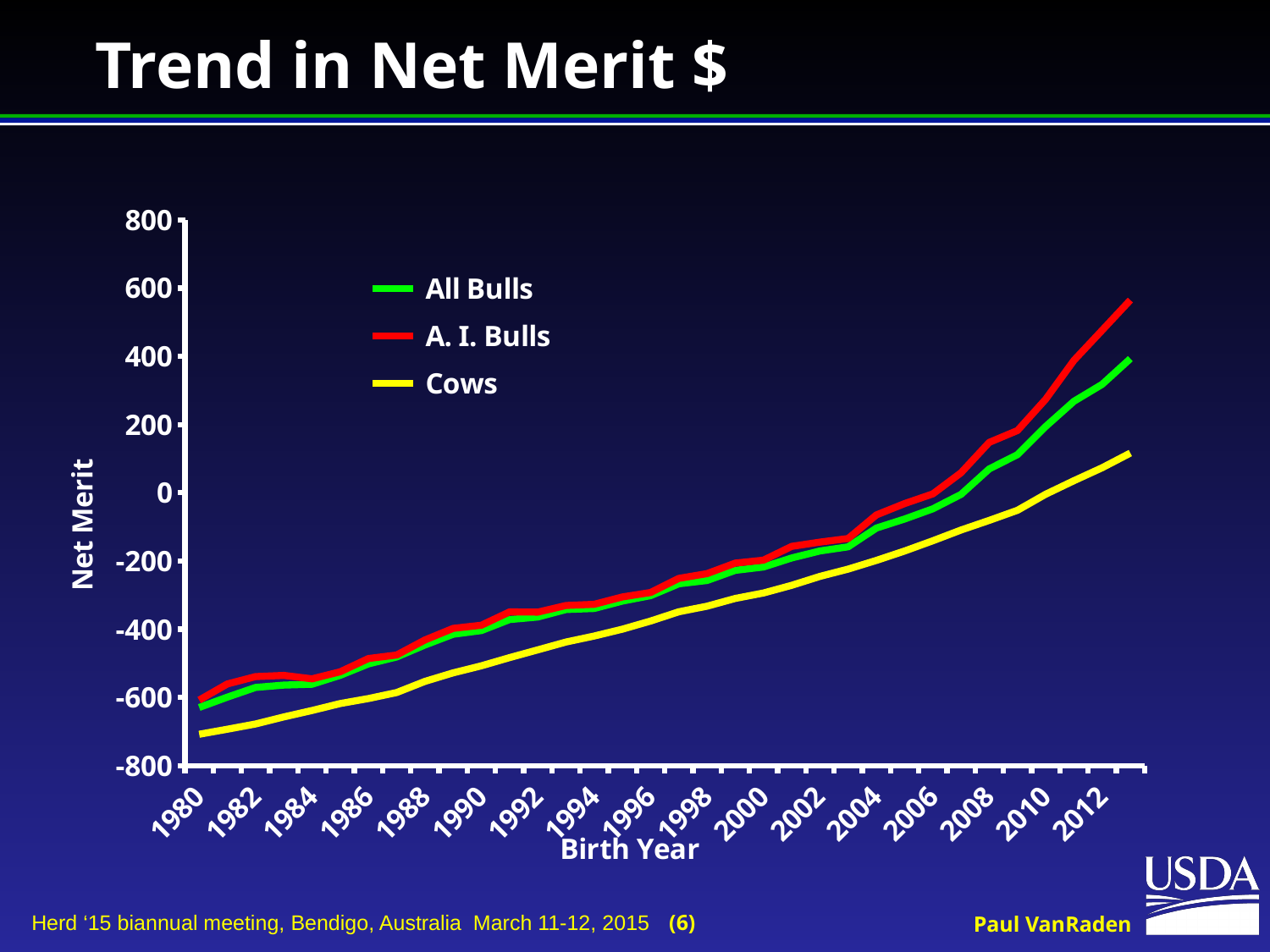
What kind of chart is shown on the slide? line chart Which series has the lowest Net Merit across the birth years shown? Cows Which series has the highest Net Merit at the last birth year shown? A. I. Bulls Is the Net Merit value for Cows in 1980 greater or less than -600? less Is the Net Merit value for Cows in 2000 greater or less than -200? less What is the title of the chart on the slide? Trend in Net Merit $ Which series is drawn in yellow? Cows How many series does the legend list? 3 Is the Net Merit value for A. I. Bulls at the last birth year shown greater or less than 400? greater In 1990, which has the higher Net Merit, All Bulls or Cows? All Bulls Do the Net Merit values for A. I. Bulls rise or fall as birth year increases? rise